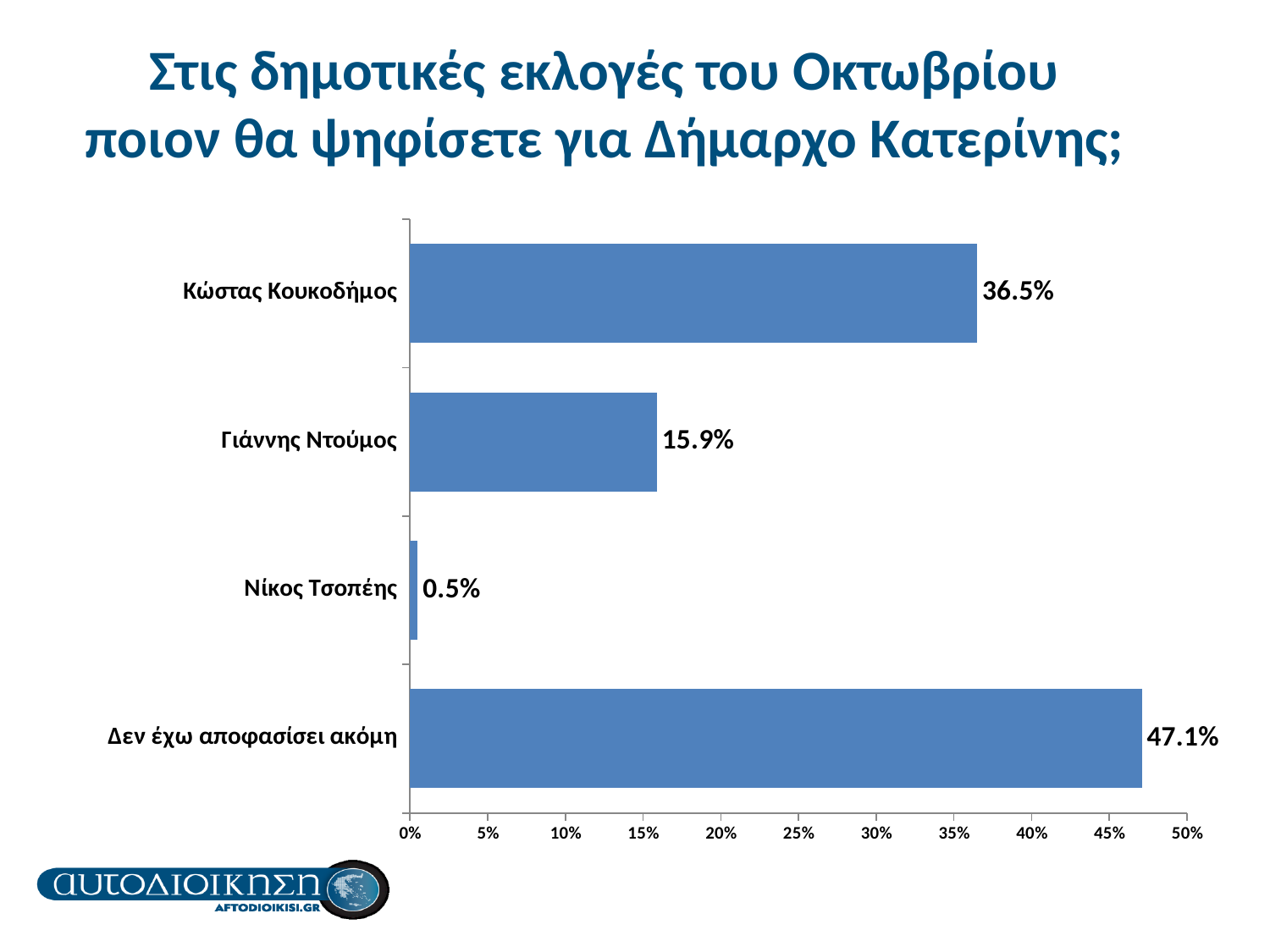
What is the value for Γιάννης Ντούμος? 15.9% What is the difference between the values for Κώστας Κουκοδήμος and Γιάννης Ντούμος? 20.6% What is the maximum value shown on the horizontal axis? 50% Is the value for Γιάννης Ντούμος greater or less than 20%? less What is the value for Δεν έχω αποφασίσει ακόμη? 47.1% What kind of chart is shown on the slide? bar chart How many categories are shown in the chart? 4 Which is larger, the value for Κώστας Κουκοδήμος or the value for Δεν έχω αποφασίσει ακόμη? Δεν έχω αποφασίσει ακόμη What is the value for Κώστας Κουκοδήμος? 36.5% Which category has the lowest value? Νίκος Τσοπέης Which category has the highest value? Δεν έχω αποφασίσει ακόμη What is the value for Νίκος Τσοπέης? 0.5%